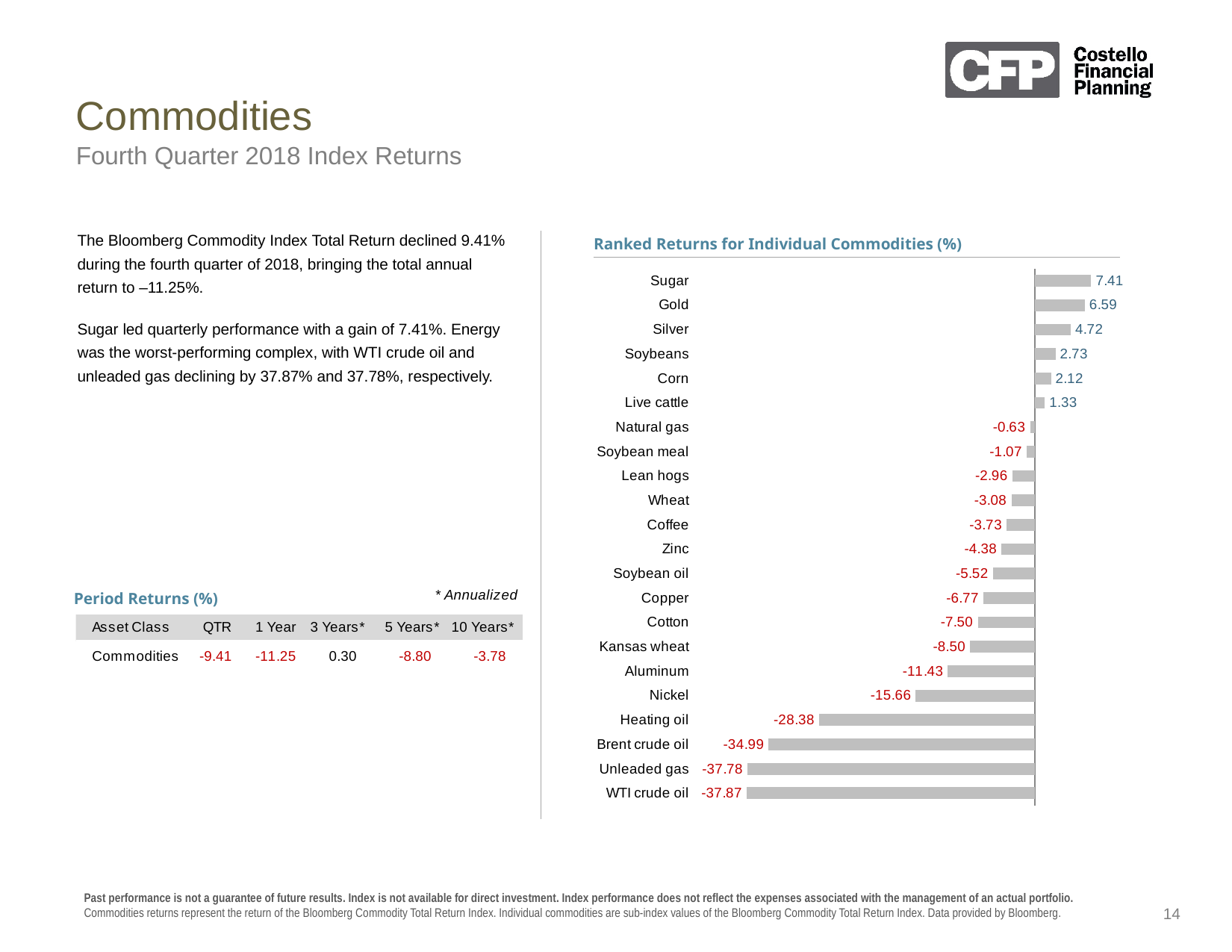
What is the return shown for Brent crude oil in the chart? -34.99 What is the difference between the returns for Nickel and Heating oil in the chart? 12.72 Which has the higher return in the chart, Silver or Soybeans? Silver What is the return shown for Sugar in the Ranked Returns for Individual Commodities chart? 7.41 How many commodities are shown in the Ranked Returns for Individual Commodities chart? 22 What type of chart is used to show the ranked returns for individual commodities? Bar chart What is the return shown for Live cattle in the chart? 1.33 What is the title of the chart on the slide? Ranked Returns for Individual Commodities (%) Which commodity has the lowest return in the chart? WTI crude oil What is the return shown for Copper in the chart? -6.77 Which commodity has the highest return in the chart? Sugar What is the difference between the returns for Sugar and Gold in the chart? 0.82